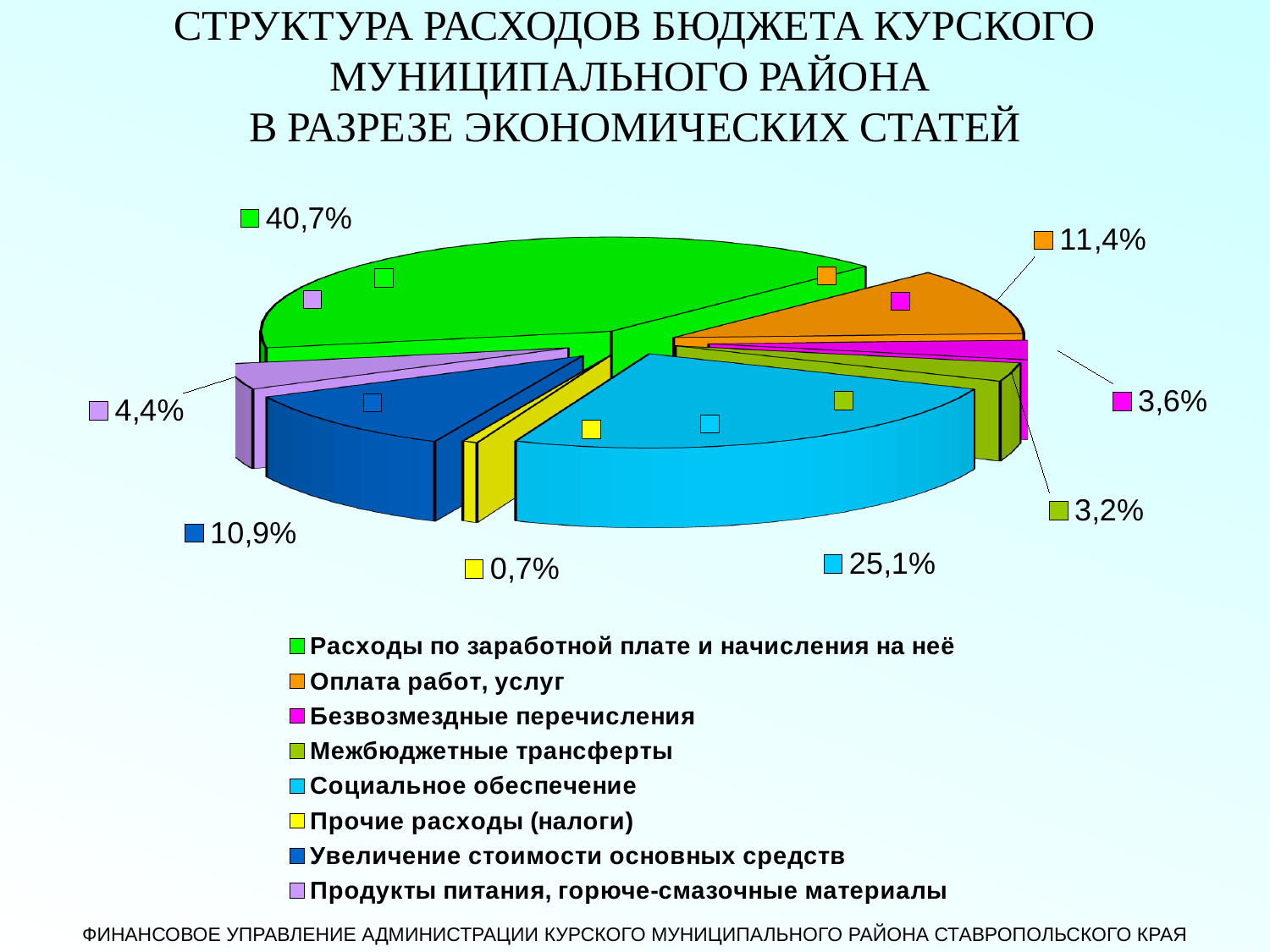
What share of expenditures is for Прочие расходы (налоги)? 0,7% What share of expenditures is for Социальное обеспечение? 25,1% What share of expenditures is for Расходы по заработной плате и начисления на неё? 40,7% Which category has the largest share of expenditures? Расходы по заработной плате и начисления на неё What share of expenditures is for Оплата работ, услуг? 11,4% What share of expenditures is for Увеличение стоимости основных средств? 10,9% Which is larger: the share for Безвозмездные перечисления or for Межбюджетные трансферты? Безвозмездные перечисления Which colour represents Продукты питания, горюче-смазочные материалы in the chart? Lavender (light purple) What type of chart is shown on the slide? Pie chart How many categories does the pie chart show? 8 Which category has the smallest share of expenditures? Прочие расходы (налоги) What is the difference in percentage points between Социальное обеспечение and Оплата работ, услуг? 13,7